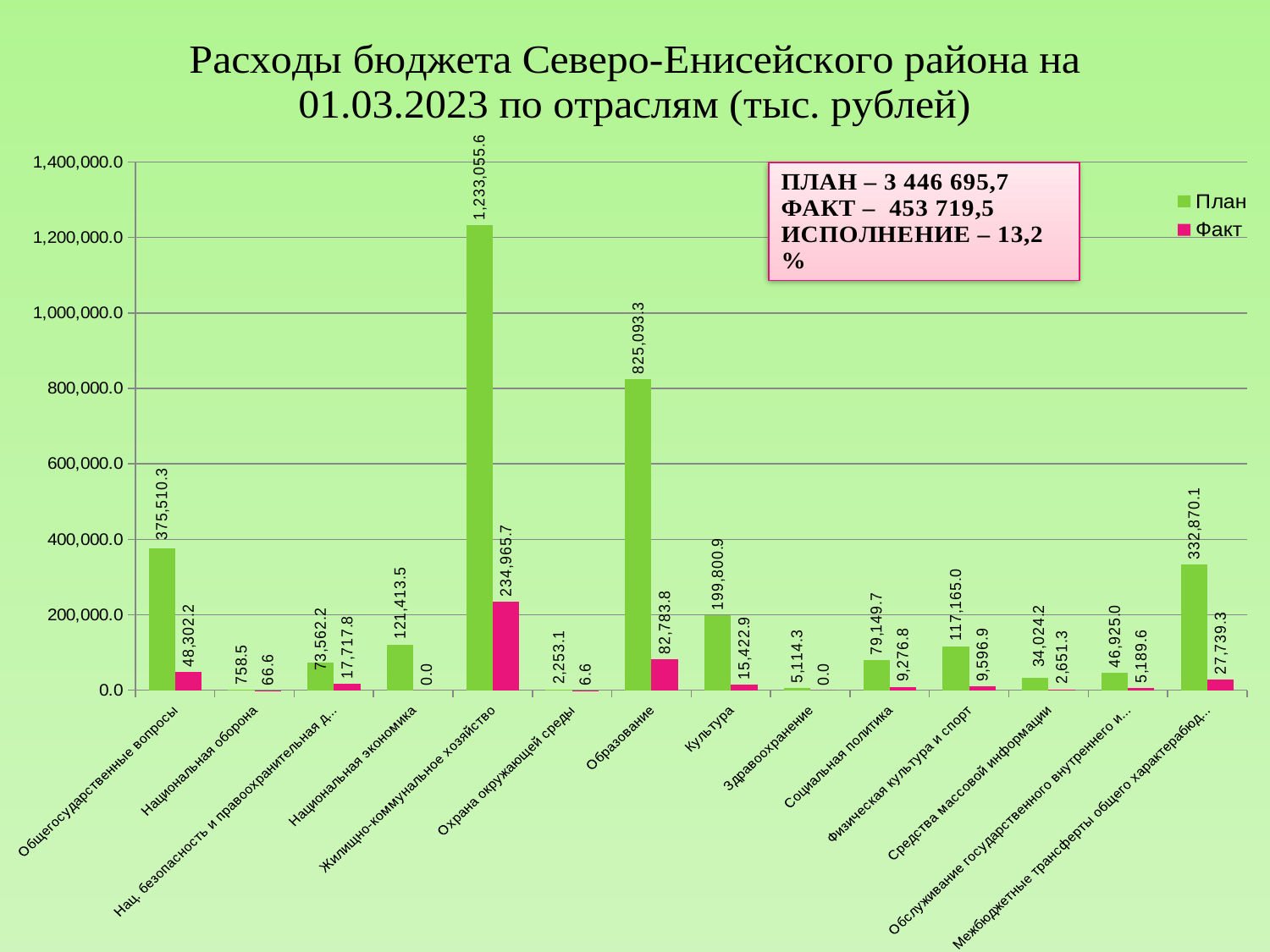
What is the Факт value for Культура? 15,422.9 Which category has the highest План value? Жилищно-коммунальное хозяйство What type of chart is shown on the slide? bar chart How many categories are shown on the x axis? 14 What is the Факт value for Жилищно-коммунальное хозяйство? 234,965.7 What is the План value for Образование? 825,093.3 How many series does the legend list? 2 What is the Факт value for Национальная экономика? 0.0 What is the difference between the План and Факт values for Образование? 742,309.5 Which category has the lowest План value? Национальная оборона What is the ИСПОЛНЕНИЕ percentage shown in the text box on the chart? 13,2 % Which is larger, the План value for Общегосударственные вопросы or the План value for Межбюджетные трансферты общего характера? Общегосударственные вопросы